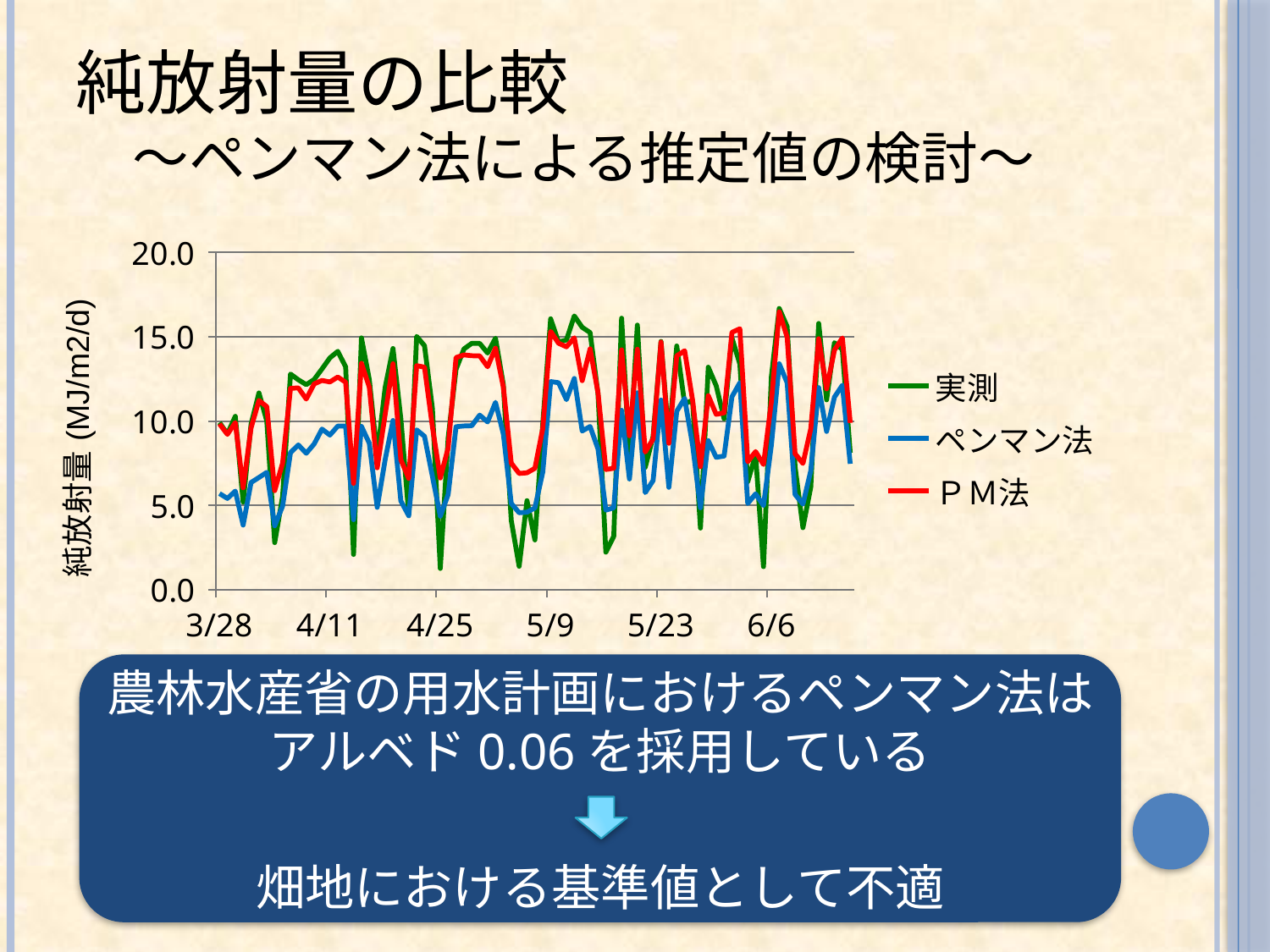
Is the 実測 value at 3/28 greater or less than 5.0? greater Is the ＰＭ法 value at 3/28 greater or less than 5.0? greater How many series does the chart's legend list? 3 What are the three series listed in the chart's legend? 実測, ペンマン法, ＰＭ法 At 3/28, which is larger: the 実測 value or the ペンマン法 value? 実測 What kind of chart is shown on the slide? line chart Which colour is used for the ペンマン法 series in the chart? blue How many date labels are shown on the x axis of the chart? 6 What is the highest tick value shown on the y axis of the chart? 20.0 Is the ペンマン法 value at 6/6 greater or less than 15.0? less